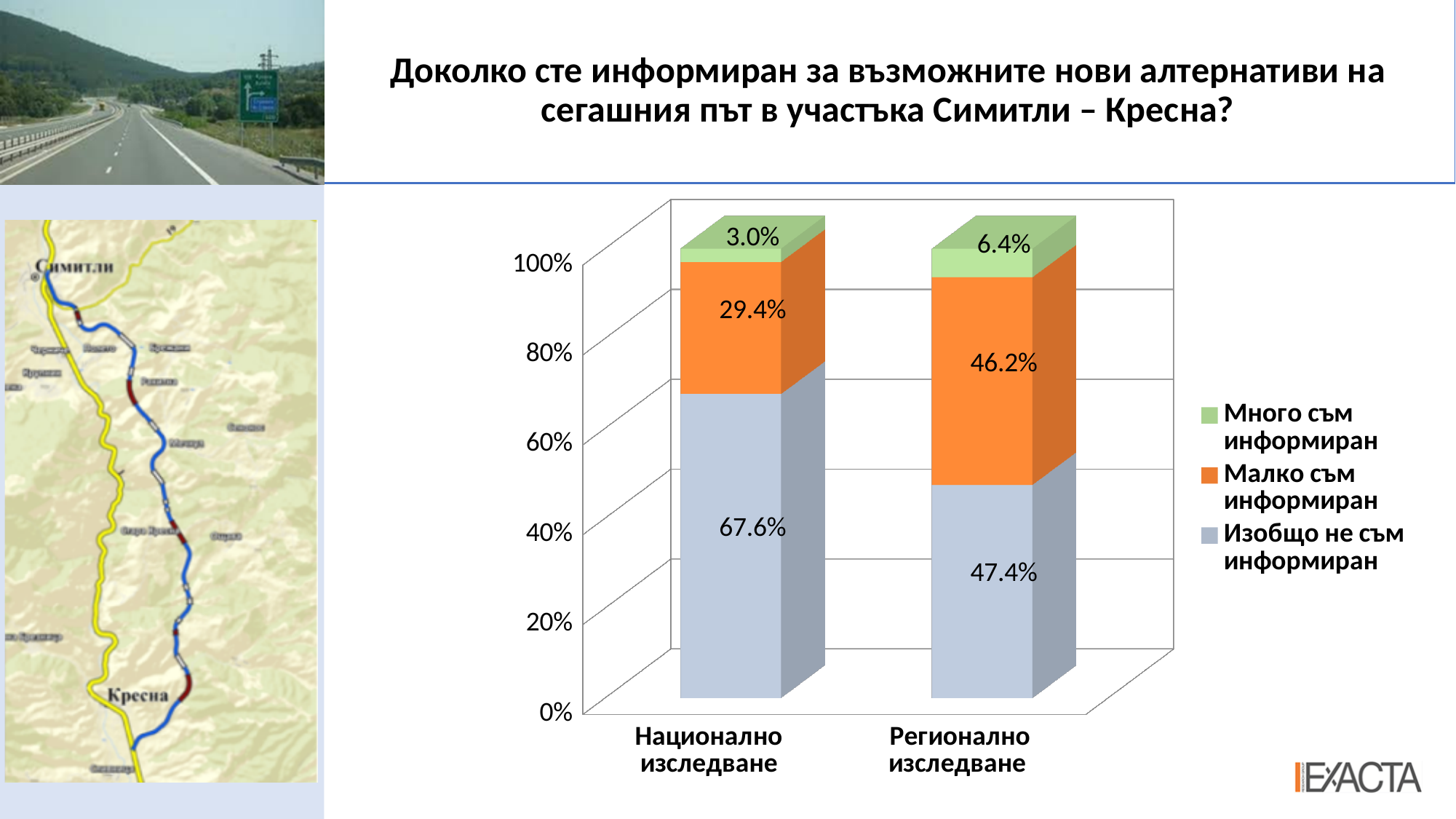
How many categories are shown on the x axis? 2 What percentage of respondents in the Регионално изследване answered Малко съм информиран? 46.2% How many series does the legend list? 3 What is the difference in percentage points between the Изобщо не съм информиран shares of the Национално изследване and the Регионално изследване? 20.2 Which survey has the higher share of Малко съм информиран responses? Регионално изследване Which survey has the higher share of Изобщо не съм информиран responses? Национално изследване What is the value for Много съм информиран in the Национално изследване? 3.0% What is the difference in percentage points between the Много съм информиран shares of the Регионално изследване and the Национално изследване? 3.4 What is the value for Много съм информиран in the Регионално изследване? 6.4% What kind of chart is shown on the slide? Stacked bar chart What percentage of respondents in the Национално изследване answered Изобщо не съм информиран? 67.6% Which response category has the smallest share in the Национално изследване? Много съм информиран